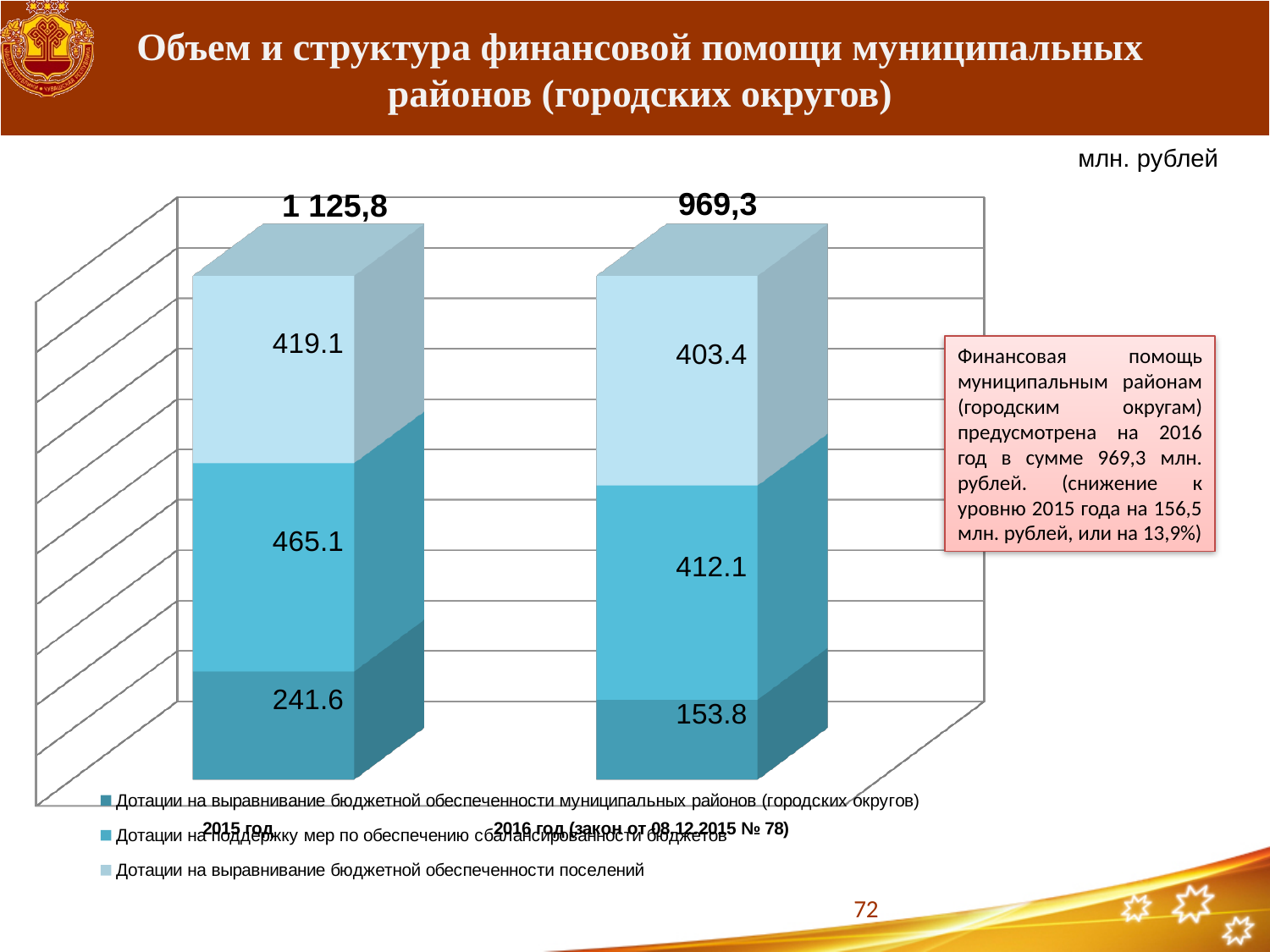
How many bars (categories) are plotted in the chart? 2 What is the value of the bottom (darkest) segment, Дотации на выравнивание бюджетной обеспеченности муниципальных районов (городских округов), for 2015 год? 241.6 What is the total value shown above the bar for 2016 год (закон от 08.12.2015 № 78)? 969,3 What unit of measurement is indicated above the chart? млн. рублей Do the total values rise or fall from 2015 to 2016? fall How many series does the legend list? 3 What type of chart is shown on the slide? stacked bar chart Which year has the larger total, 2015 год or 2016 год? 2015 год What is the difference between the bottom segment values for 2015 год (241.6) and 2016 год (153.8)? 87.8 What is the total value shown above the bar for 2015 год? 1 125,8 What is the value of the middle segment, Дотации на поддержку мер по обеспечению сбалансированности бюджетов, for 2016 год? 412.1 What is the value of the top (lightest) segment, Дотации на выравнивание бюджетной обеспеченности поселений, for 2015 год? 419.1